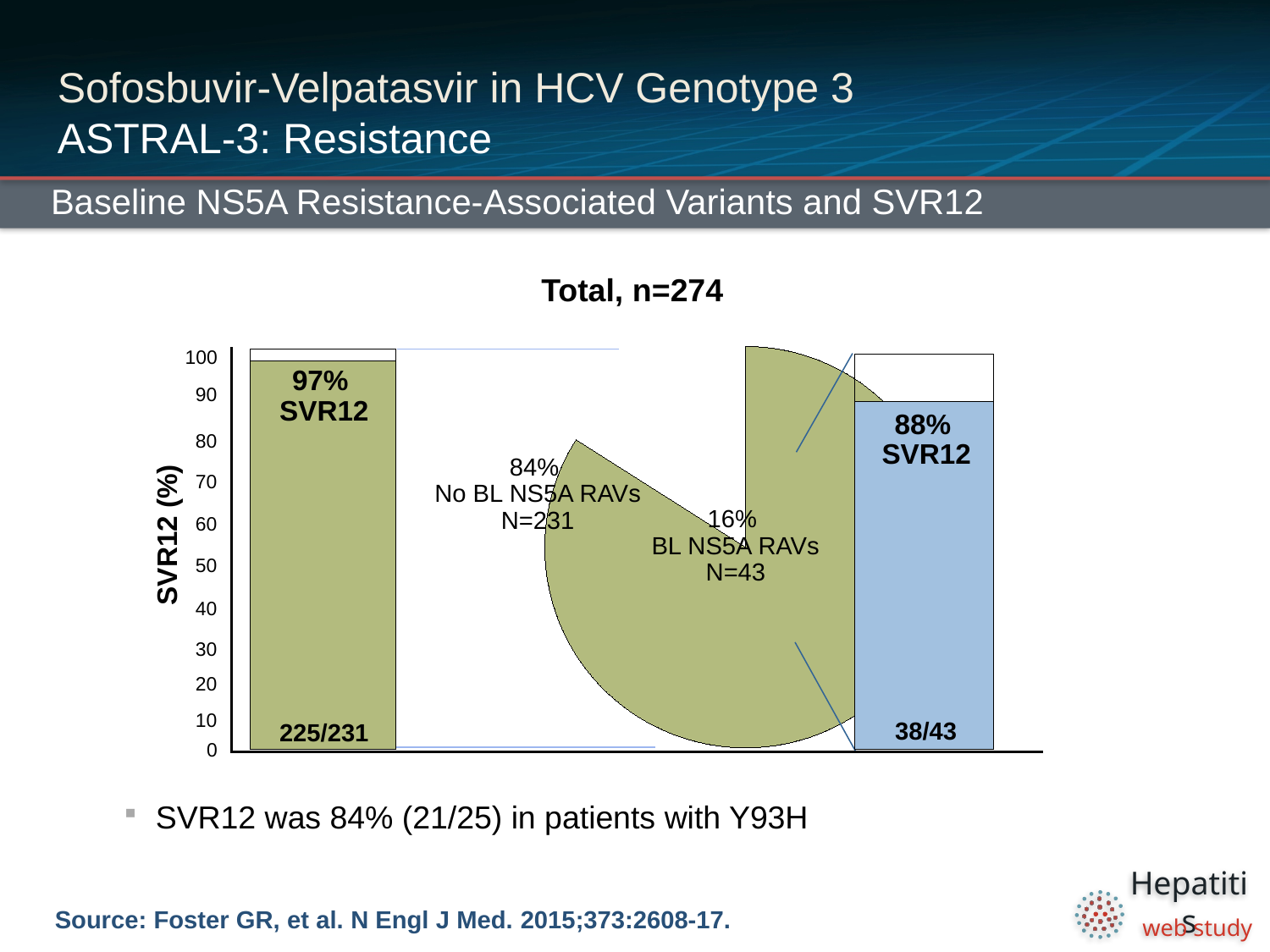
How many patients are in the 'BL NS5A RAVs' slice of the pie chart? N=43 Which group has the higher SVR12 rate: no baseline NS5A RAVs or baseline NS5A RAVs? No BL NS5A RAVs What is the SVR12 rate shown for patients with baseline NS5A RAVs? 88% What fraction of patients achieved SVR12 in the baseline NS5A RAVs group? 38/43 What is the label of the vertical axis of the bar chart? SVR12 (%) What is the SVR12 rate shown for patients with no baseline NS5A RAVs? 97% What fraction of patients achieved SVR12 in the no baseline NS5A RAVs group? 225/231 What share of the pie chart is labelled 'BL NS5A RAVs'? 16% What is the total number of patients shown above the chart? n=274 What is the difference in SVR12 rate between the no baseline NS5A RAVs group and the baseline NS5A RAVs group? 9% What share of the pie chart is labelled 'No BL NS5A RAVs'? 84% How many slices does the pie chart have? 2